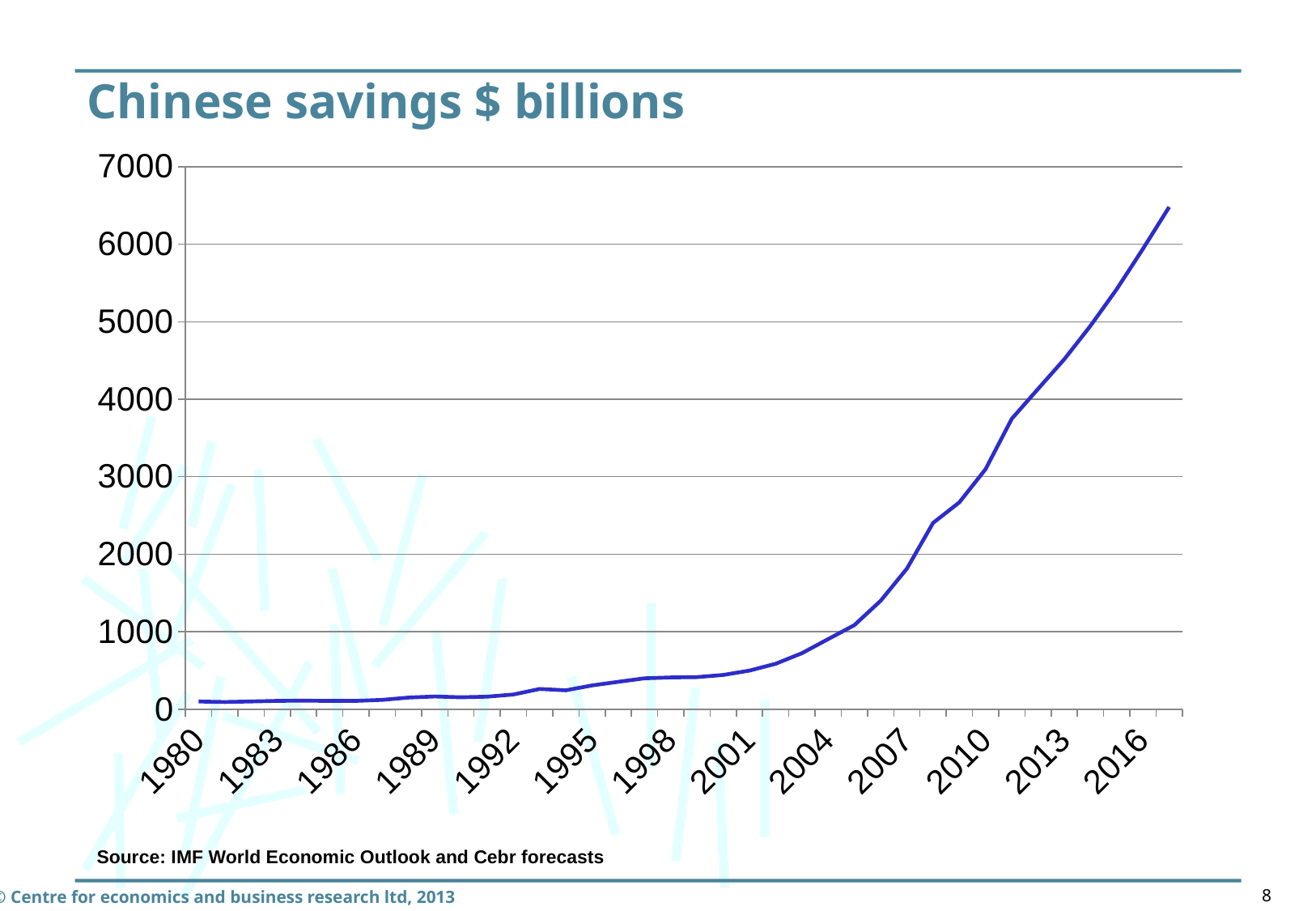
Is the value for 2007 greater or less than 1000? greater Do Chinese savings rise or fall over the period shown on the x axis? rise Which is larger, the value for 2010 or the value for 2004? 2010 What kind of chart is shown on the slide? line chart Is the value for 2007 greater or less than 2000? less Is the value for 2016 greater or less than 5000? greater What source is cited for the chart data? IMF World Economic Outlook and Cebr forecasts What is the title of the chart? Chinese savings $ billions